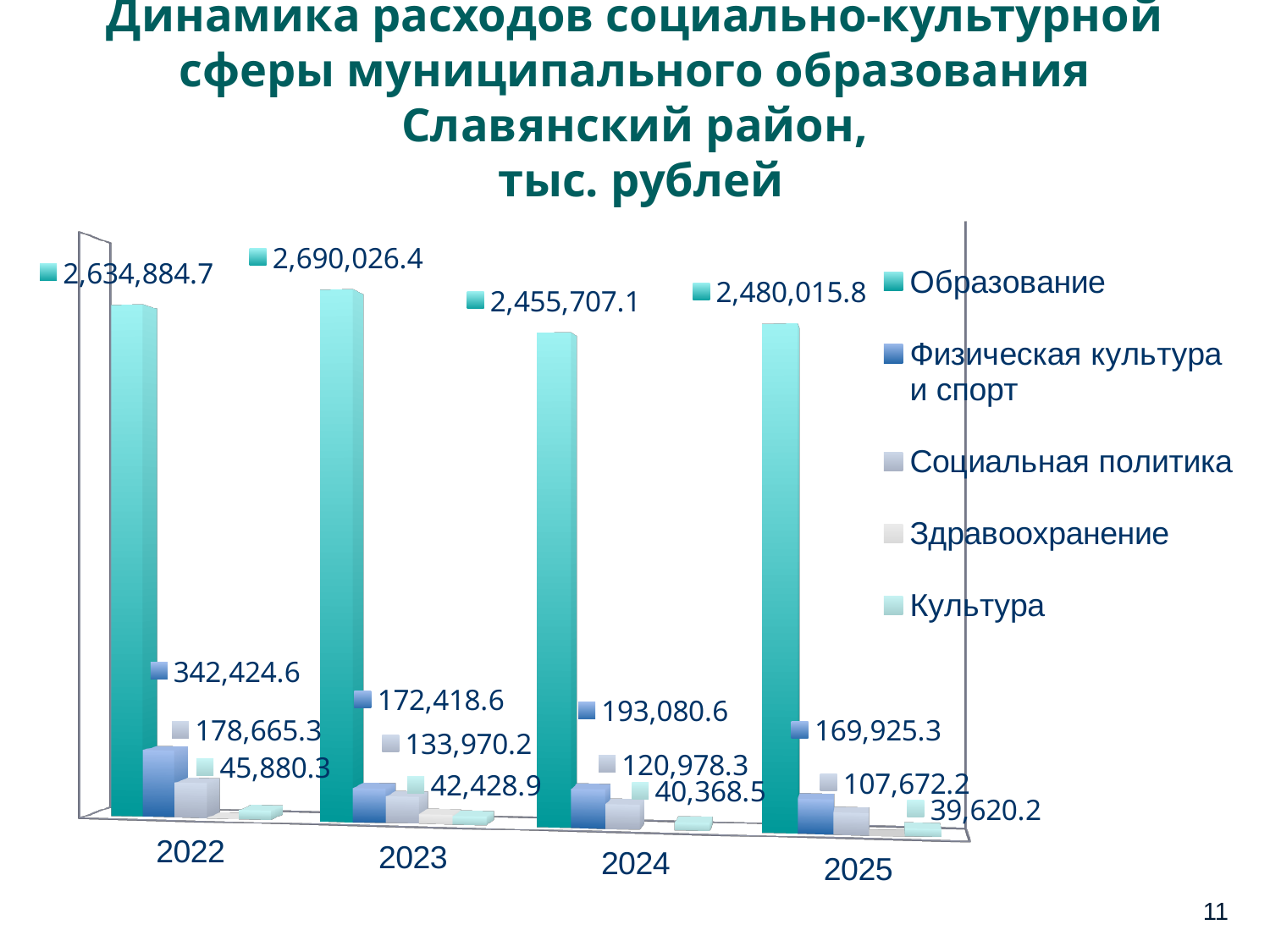
What is the value for Образование in 2023? 2,690,026.4 What kind of chart is shown on the slide? bar chart How many years are shown on the x axis? 4 How many series does the legend list? 5 Do the values for Социальная политика rise or fall from 2022 to 2025? fall Which is larger: Социальная политика in 2022 or Физическая культура и спорт in 2023? Социальная политика in 2022 In which year is the value for Образование the highest? 2023 What is the difference between the Образование values for 2023 and 2022? 55,141.7 What is the value for Культура in 2024? 40,368.5 What is the value for Физическая культура и спорт in 2022? 342,424.6 What is the value for Социальная политика in 2025? 107,672.2 In which year is the value for Физическая культура и спорт the lowest? 2025